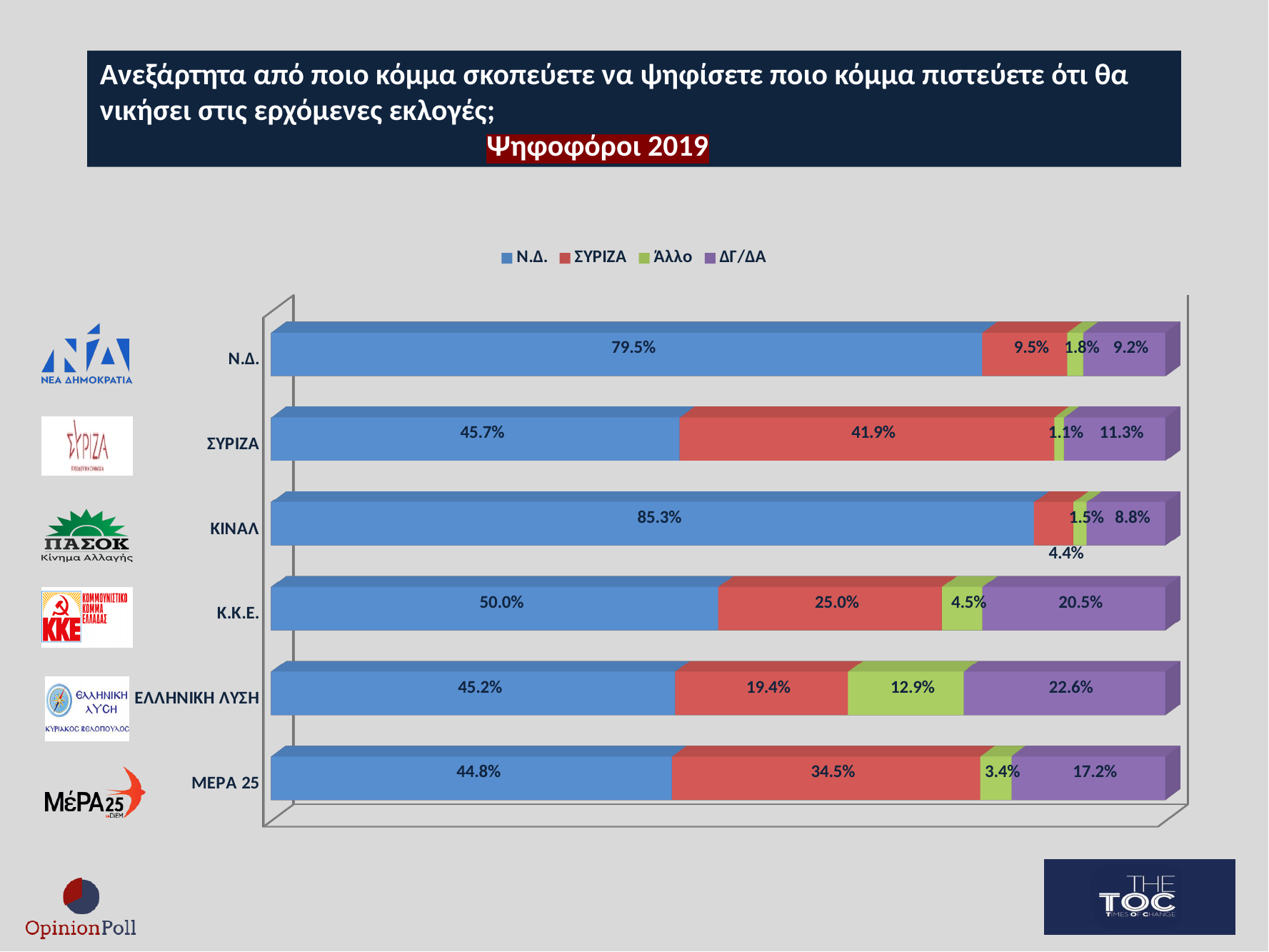
What type of chart is shown on the slide? Stacked bar chart What is the difference between the Ν.Δ. value and the ΣΥΡΙΖΑ value for Κ.Κ.Ε. voters? 25.0% What share of ΣΥΡΙΖΑ voters believe ΣΥΡΙΖΑ will win the next elections? 41.9% What share of ΚΙΝΑΛ voters believe Ν.Δ. will win the next elections? 85.3% Which is larger for ΜΕΡΑ 25 voters: the ΣΥΡΙΖΑ value or the ΔΓ/ΔΑ value? ΣΥΡΙΖΑ How many series does the legend list? 4 Which voter group has the lowest Ν.Δ. value? ΜΕΡΑ 25 What is the Άλλο value for ΜΕΡΑ 25 voters? 3.4% How many voter groups (categories) are shown on the chart? 6 What is the ΔΓ/ΔΑ value for ΕΛΛΗΝΙΚΗ ΛΥΣΗ voters? 22.6% Which series is shown in green in the legend? Άλλο Which voter group has the highest Ν.Δ. value? ΚΙΝΑΛ